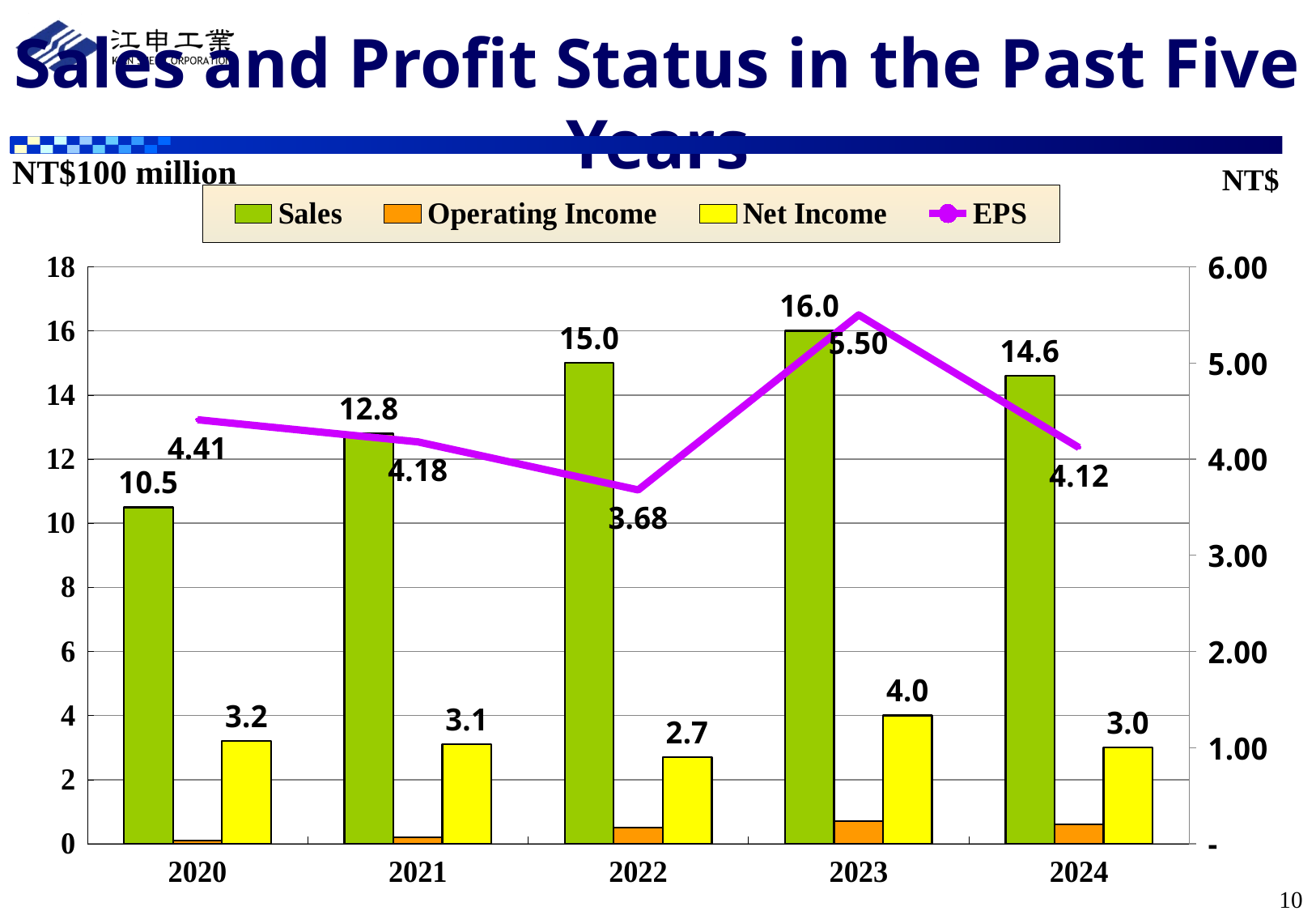
What is the EPS value for 2021? 4.18 How many series does the legend list? 4 Which year has the highest Sales? 2023 Which year has the lowest EPS? 2022 Does Sales rise or fall from 2020 to 2023? rise Which is larger, Net Income in 2021 or Net Income in 2024? Net Income in 2021 How many years are shown on the x axis? 5 What kind of chart is this? Combined bar and line chart Is the Operating Income value for 2023 greater or less than 2? less What is the Net Income value for 2022? 2.7 What is the difference between Sales in 2023 and Sales in 2020? 5.5 What is the Sales value for 2023? 16.0